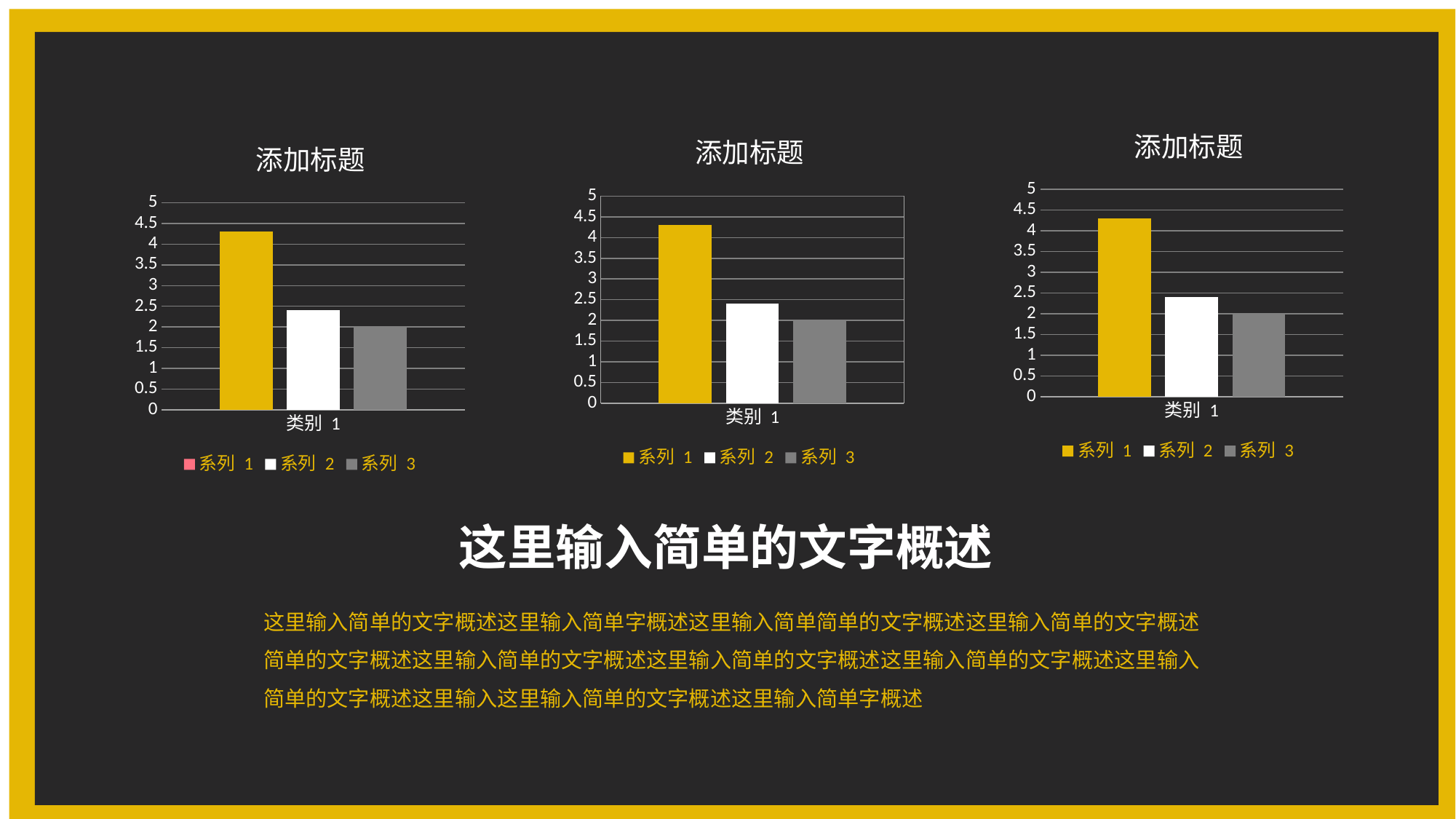
In the middle chart, is the value of 系列 1 for 类别 1 greater or less than 4.5? less In the left chart, is the value of 系列 2 for 类别 1 greater or less than 3? less What is the title of the left chart? 添加标题 What is the name of the category on the x axis of the middle chart? 类别 1 In the middle chart, which series has the lowest value for 类别 1? 系列 3 How many categories are shown on the x axis of the right chart? 1 In the right chart, which is larger for 类别 1: 系列 1 or 系列 2? 系列 1 In the right chart, is the value of 系列 1 for 类别 1 greater or less than 4? greater What kind of chart is the left chart on the slide? bar chart In the middle chart, what is the value of 系列 3 for 类别 1? 2 How many series does the legend of the middle chart list? 3 In the left chart, which series has the highest value for 类别 1? 系列 1